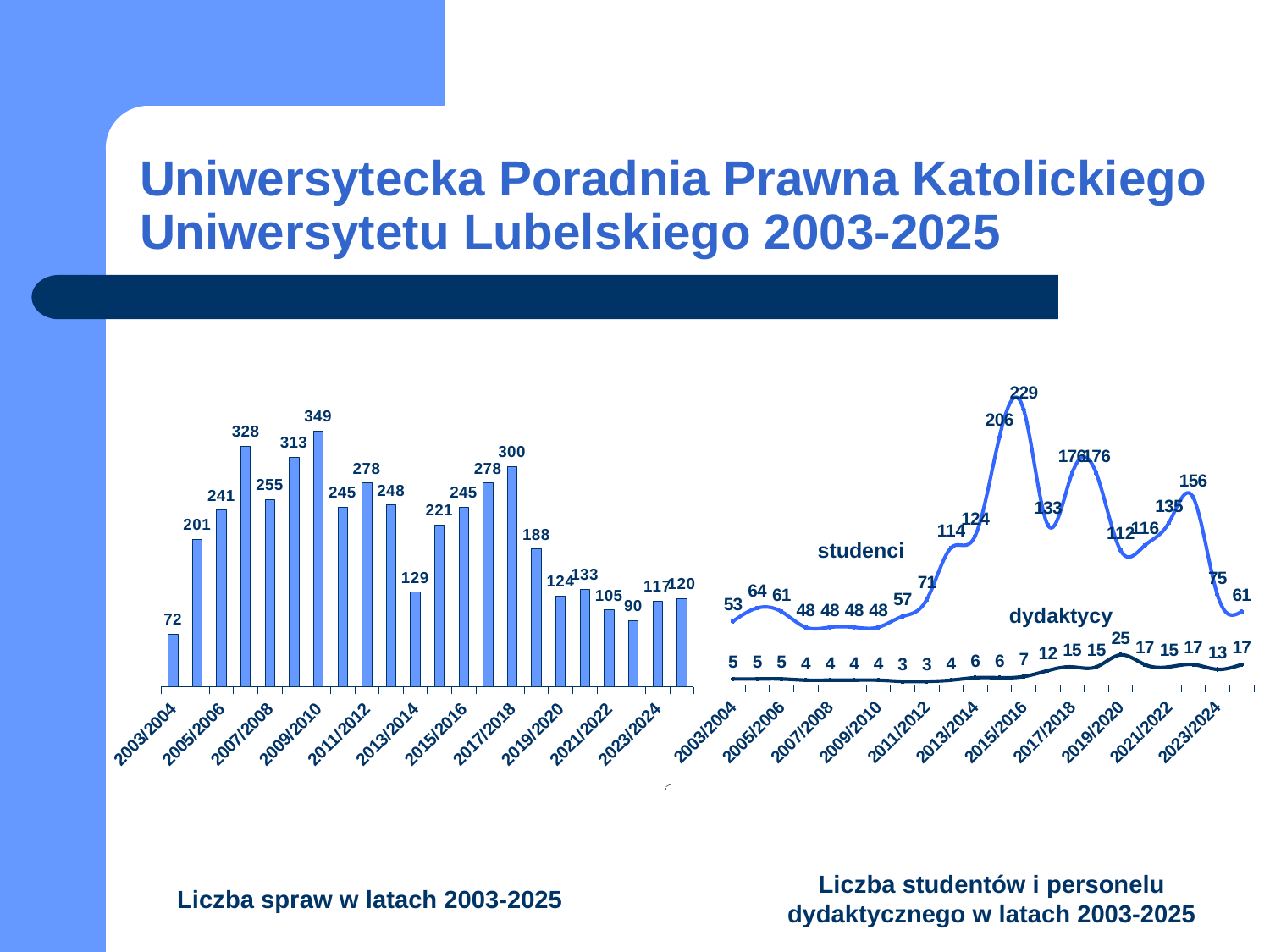
What type of chart is the right chart, 'Liczba studentów i personelu dydaktycznego w latach 2003-2025'? line chart In the right chart, what is the highest value of the 'dydaktycy' series? 25 In the right chart, what is the value of 'dydaktycy' for 2003/2004? 5 How many series does the right chart 'Liczba studentów i personelu dydaktycznego w latach 2003-2025' show? 2 In the right chart, what is the highest value of the 'studenci' series? 229 In the left chart 'Liczba spraw w latach 2003-2025', what is the lowest value shown? 72 In the right chart, which series has the higher values throughout, 'studenci' or 'dydaktycy'? studenci What type of chart is the left chart, 'Liczba spraw w latach 2003-2025'? bar chart In the left chart 'Liczba spraw w latach 2003-2025', what is the value for 2003/2004? 72 In the left chart 'Liczba spraw w latach 2003-2025', what is the highest value shown? 349 In the right chart, what is the value of 'studenci' for 2003/2004? 53 In the left chart 'Liczba spraw w latach 2003-2025', what is the difference between the highest value (349) and the lowest value (72)? 277